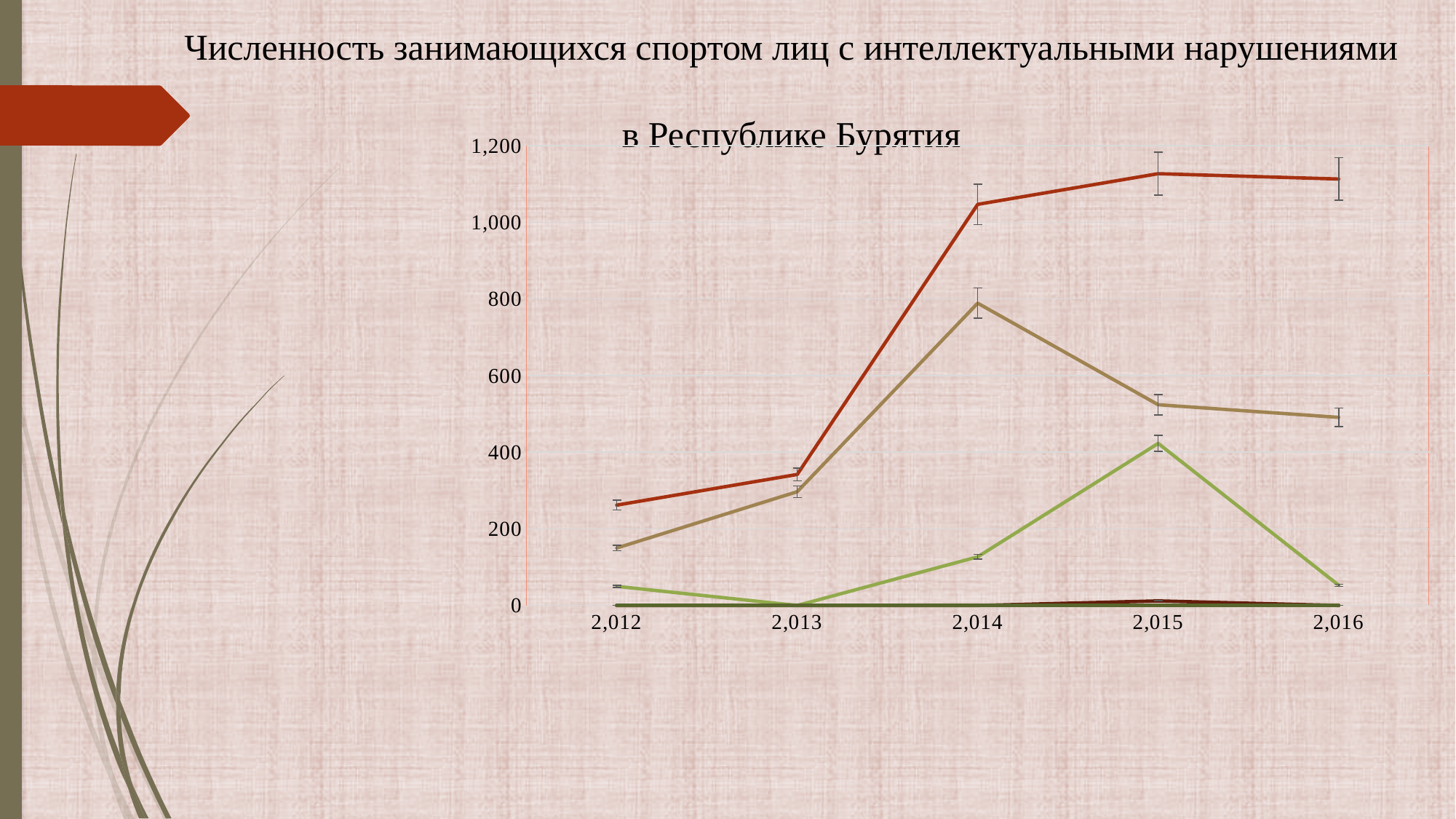
In 2,014, which line has the larger value, the red line or the tan (brown) line? the red line In which year does the light green line reach its highest value? 2,015 Is the value of the light green line in 2,016 greater or less than 200? less Does the tan (brown) line rise or fall between 2,014 and 2,016? fall What is the title of the chart on the slide? Численность занимающихся спортом лиц с интеллектуальными нарушениями в Республике Бурятия Is the value of the tan (brown) line in 2,014 greater or less than 600? greater In which year does the tan (brown) line reach its highest value? 2,014 How many years are shown along the x axis of the chart? 5 Is the value of the tan (brown) line in 2,016 greater or less than 600? less What kind of chart is shown on the slide? line chart